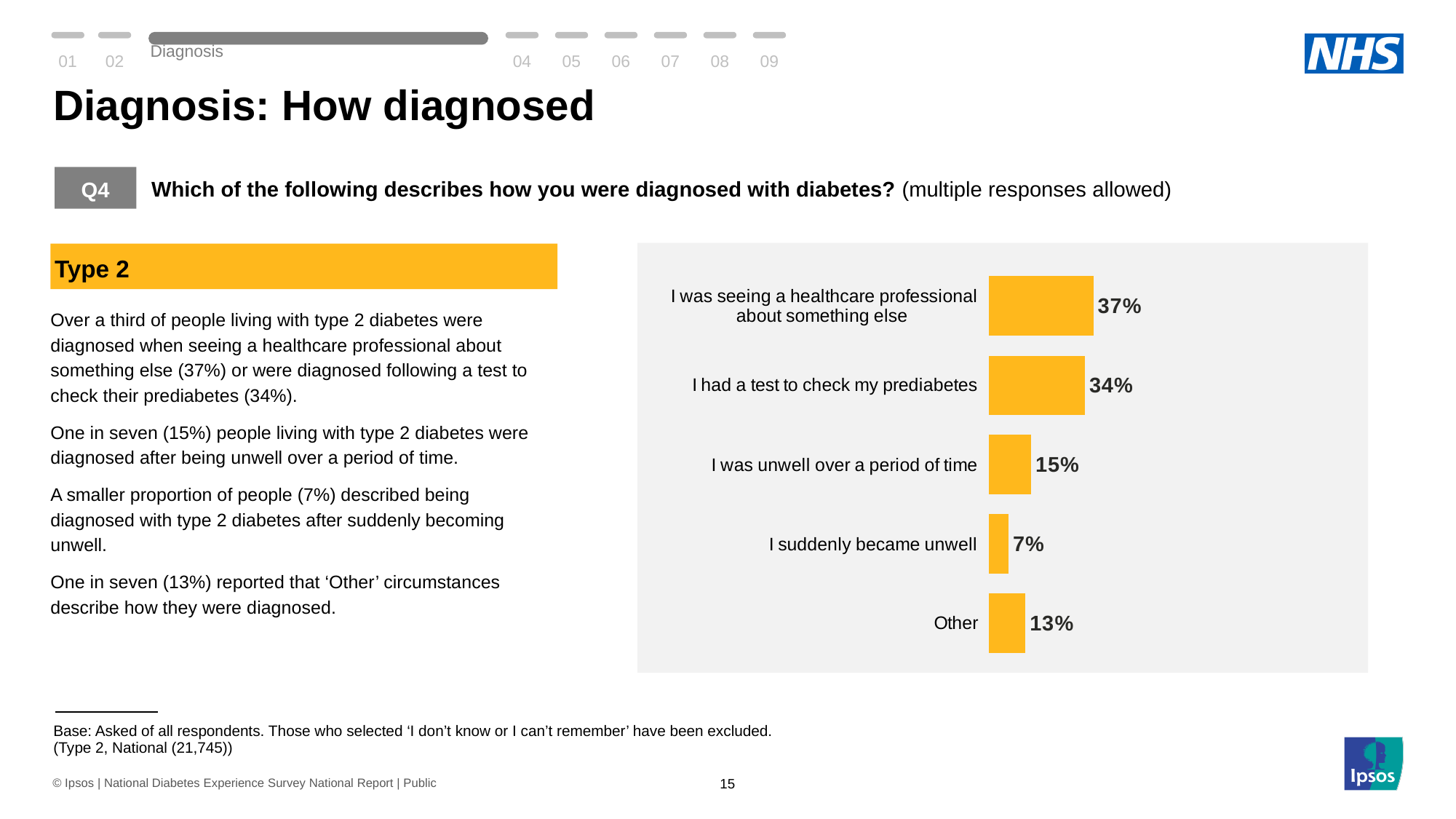
What percentage of respondents said they were unwell over a period of time? 15% How many response categories are shown in the chart? 5 What is the difference in percentage points between 'I was seeing a healthcare professional about something else' and 'I had a test to check my prediabetes'? 3 percentage points Which response has the lowest percentage? I suddenly became unwell What type of chart is shown on the slide? Bar chart What percentage of respondents said they were seeing a healthcare professional about something else when diagnosed? 37% What percentage of respondents said they suddenly became unwell? 7% What colour are the bars in the chart? Yellow/orange What percentage of respondents selected 'Other'? 13% What percentage of respondents said they had a test to check their prediabetes? 34% Which response has the highest percentage? I was seeing a healthcare professional about something else Which is larger: the percentage for 'I was unwell over a period of time' or for 'Other'? I was unwell over a period of time